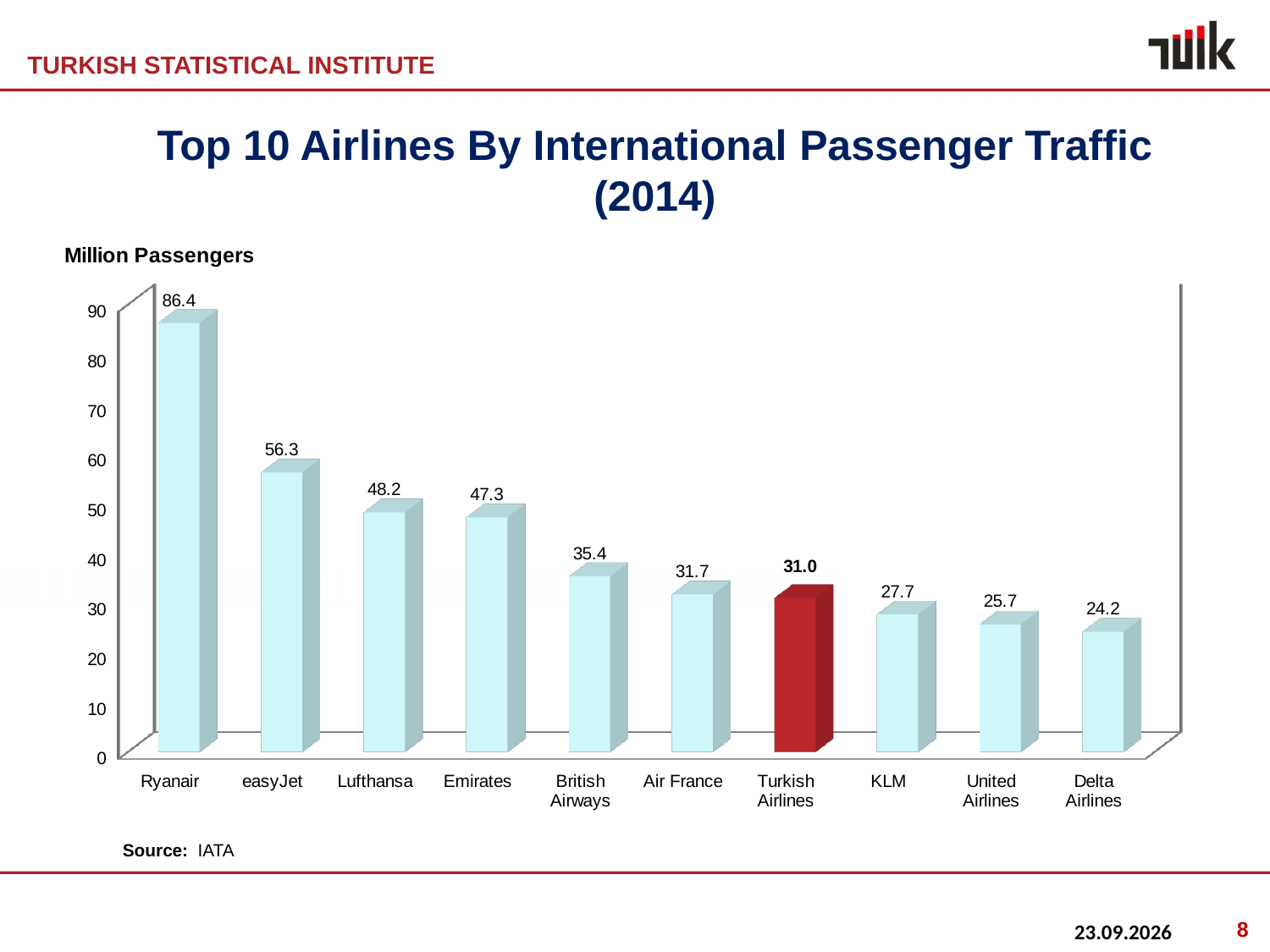
Is the value for Emirates greater or less than 40? greater Which is larger, the value for British Airways or the value for Air France? British Airways Which airline has the highest international passenger traffic? Ryanair Which airline's bar is highlighted in red? Turkish Airlines What is the value for KLM? 27.7 What is the value for Turkish Airlines? 31.0 What kind of chart is shown on the slide? bar chart How many airlines are shown in the chart? 10 What is the value for Lufthansa? 48.2 What is the difference between the values for Ryanair and easyJet? 30.1 What is the difference between the values for Turkish Airlines and KLM? 3.3 Which airline has the lowest international passenger traffic? Delta Airlines